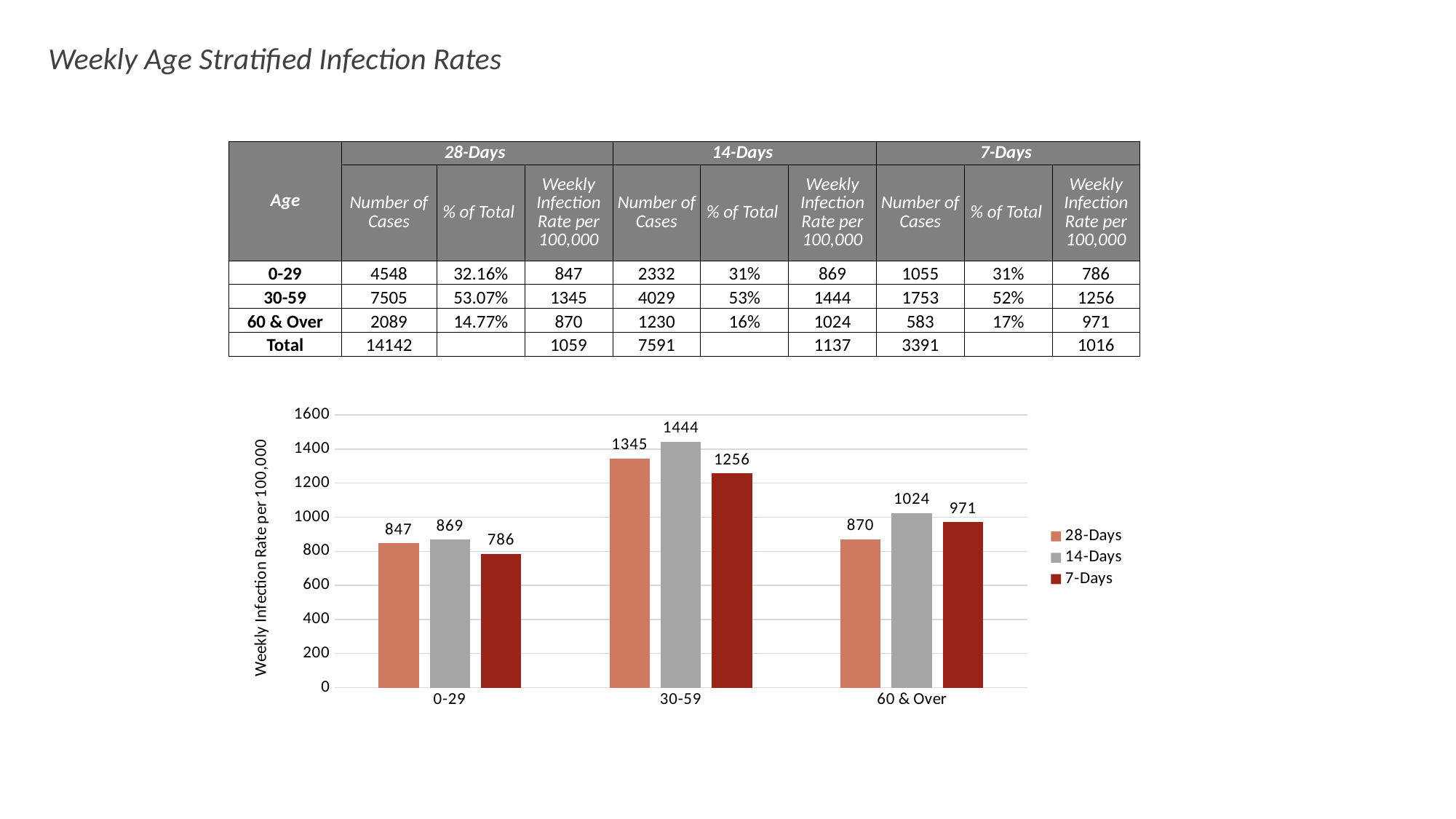
Is the 7-Days weekly infection rate for the 30-59 age group greater or less than 1200? greater What kind of chart is shown on the slide? Bar chart Which age group has the highest 14-Days weekly infection rate? 30-59 What is the 7-Days weekly infection rate per 100,000 for the 0-29 age group? 786 What is the 14-Days weekly infection rate per 100,000 for the 30-59 age group? 1444 What is the difference between the 7-Days and 28-Days weekly infection rates for the 60 & Over age group? 101 What is the 28-Days weekly infection rate per 100,000 for the 60 & Over age group? 870 What is the difference between the 14-Days and 28-Days weekly infection rates for the 30-59 age group? 99 Which is larger for the 60 & Over age group: the 14-Days rate or the 7-Days rate? 14-Days Which age group has the lowest 7-Days weekly infection rate? 0-29 How many age groups are shown on the x axis of the chart? 3 How many series does the chart legend list? 3